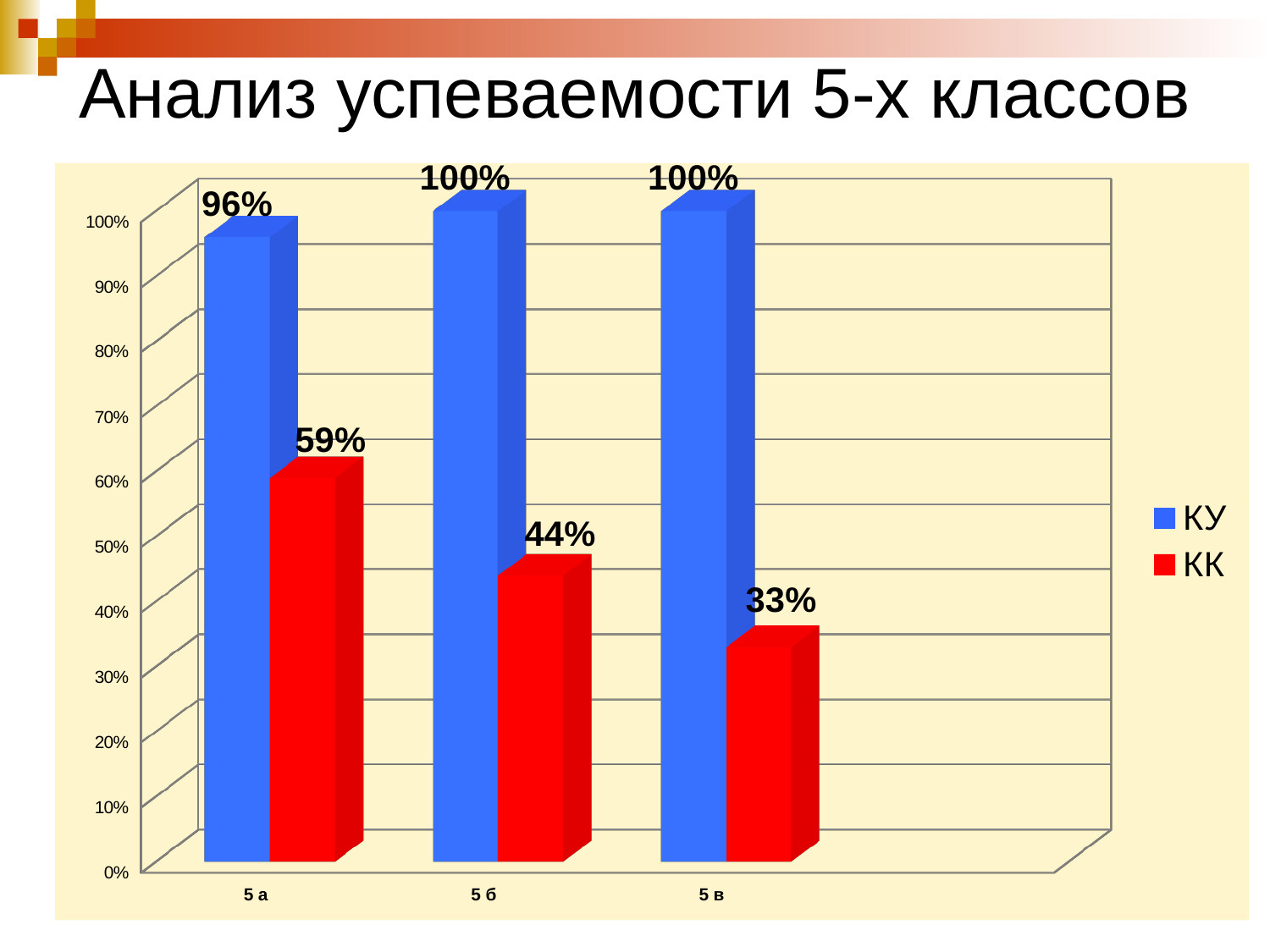
What is the КК value for class 5 в? 33% How many classes are shown on the x axis? 3 How many series does the legend list? 2 What is the КК value for class 5 б? 44% Which is larger, the КК value for 5 б or for 5 в? 5 б What kind of chart is shown on the slide? bar chart What is the difference between the КК values for 5 а and 5 в? 26% What colour represents the КК series? red Which class has the lowest КУ value? 5 а What is the КУ value for class 5 а? 96% Is the КК value for 5 а greater or less than 50%? greater Which class has the highest КК value? 5 а